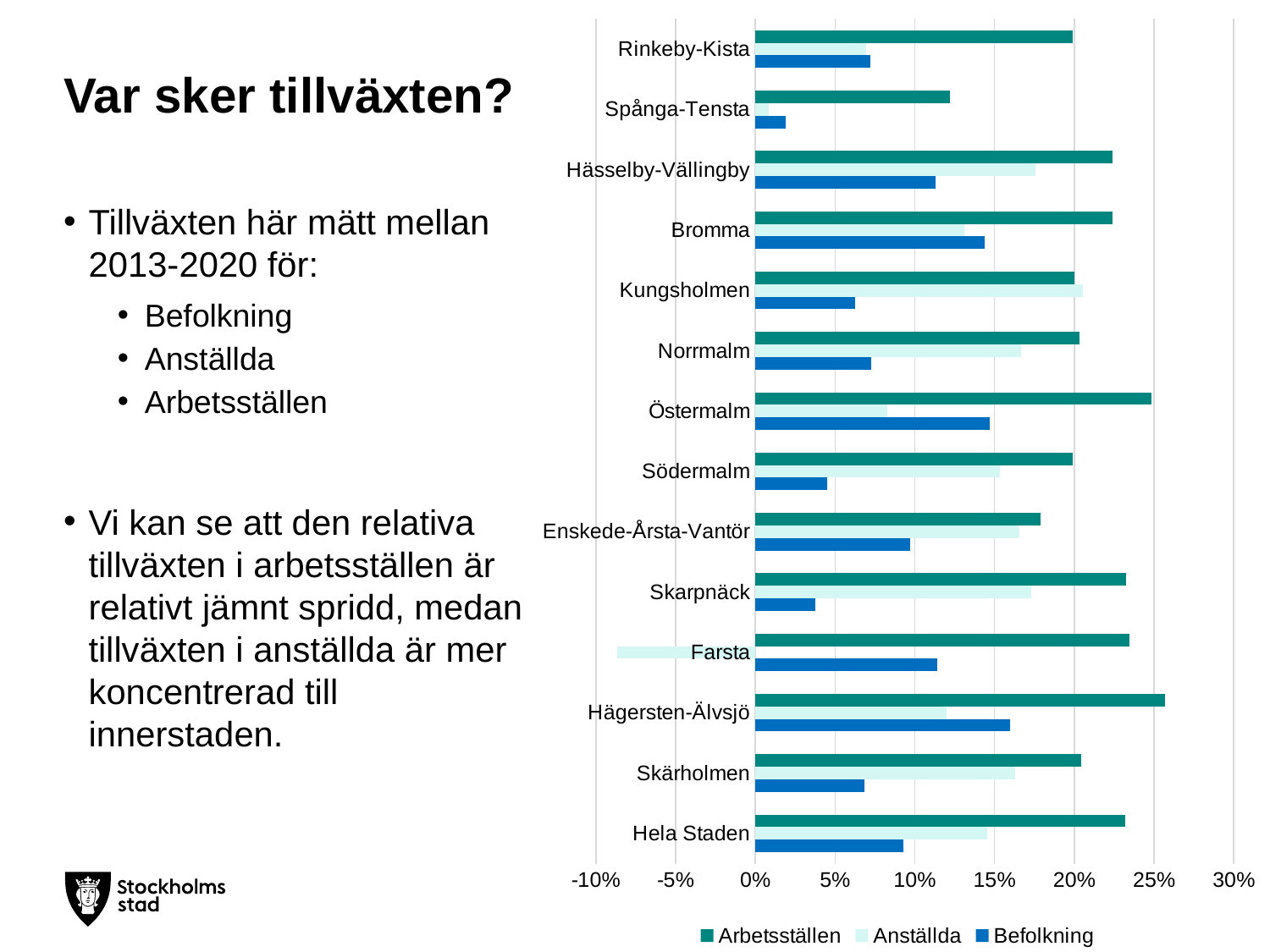
What kind of chart is shown on the slide? bar chart Is the Arbetsställen value for Hägersten-Älvsjö greater or less than 20%? greater Is the Befolkning value for Spånga-Tensta greater or less than 5%? less For Östermalm, which is larger: the Befolkning value or the Anställda value? Befolkning Which category has the lowest Befolkning value? Spånga-Tensta Which category has the lowest Anställda value? Farsta For Kungsholmen, which is larger: the Arbetsställen value or the Befolkning value? Arbetsställen How many series does the legend list? 3 How many categories (districts) are shown on the chart? 14 Is the Befolkning value for Skarpnäck greater or less than 5%? less Which series is shown in dark blue in the legend? Befolkning